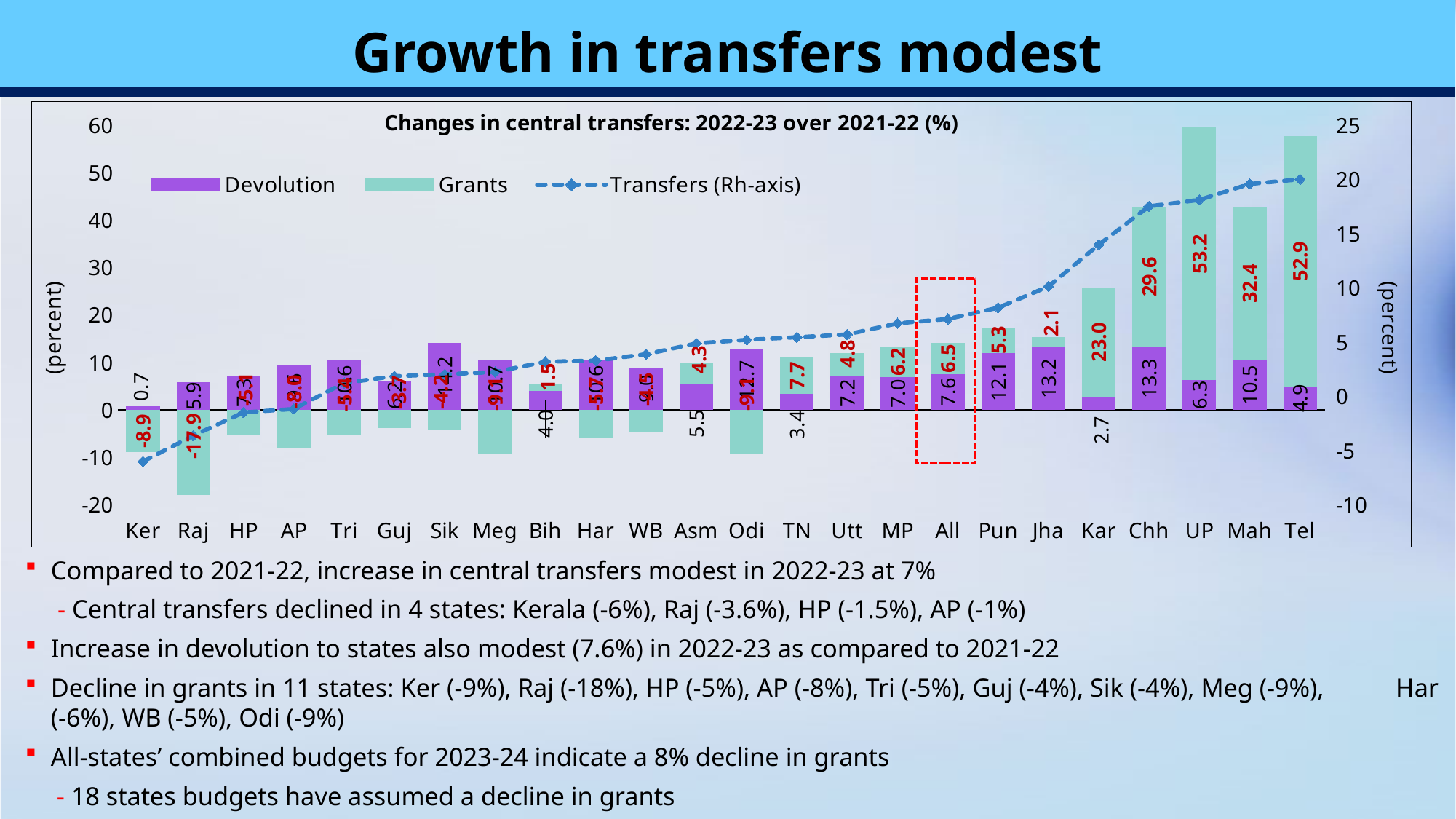
How many state categories are shown on the x axis? 24 Which has the larger Devolution value, Chh or Pun? Chh What is the Grants value for Raj? -17.9 Which state has the lowest Grants value? Raj What kind of chart is shown on the slide? Bar chart with a line What is the Devolution value for Jha? 13.2 What is the Devolution value for All? 7.6 What is the difference between the Grants value and the Devolution value for Kar? 20.3 Which state has the highest Grants value? UP How many series does the legend list? 3 What is the Grants value for UP? 53.2 Is the Transfers (Rh-axis) value for Tel greater or less than 15? greater